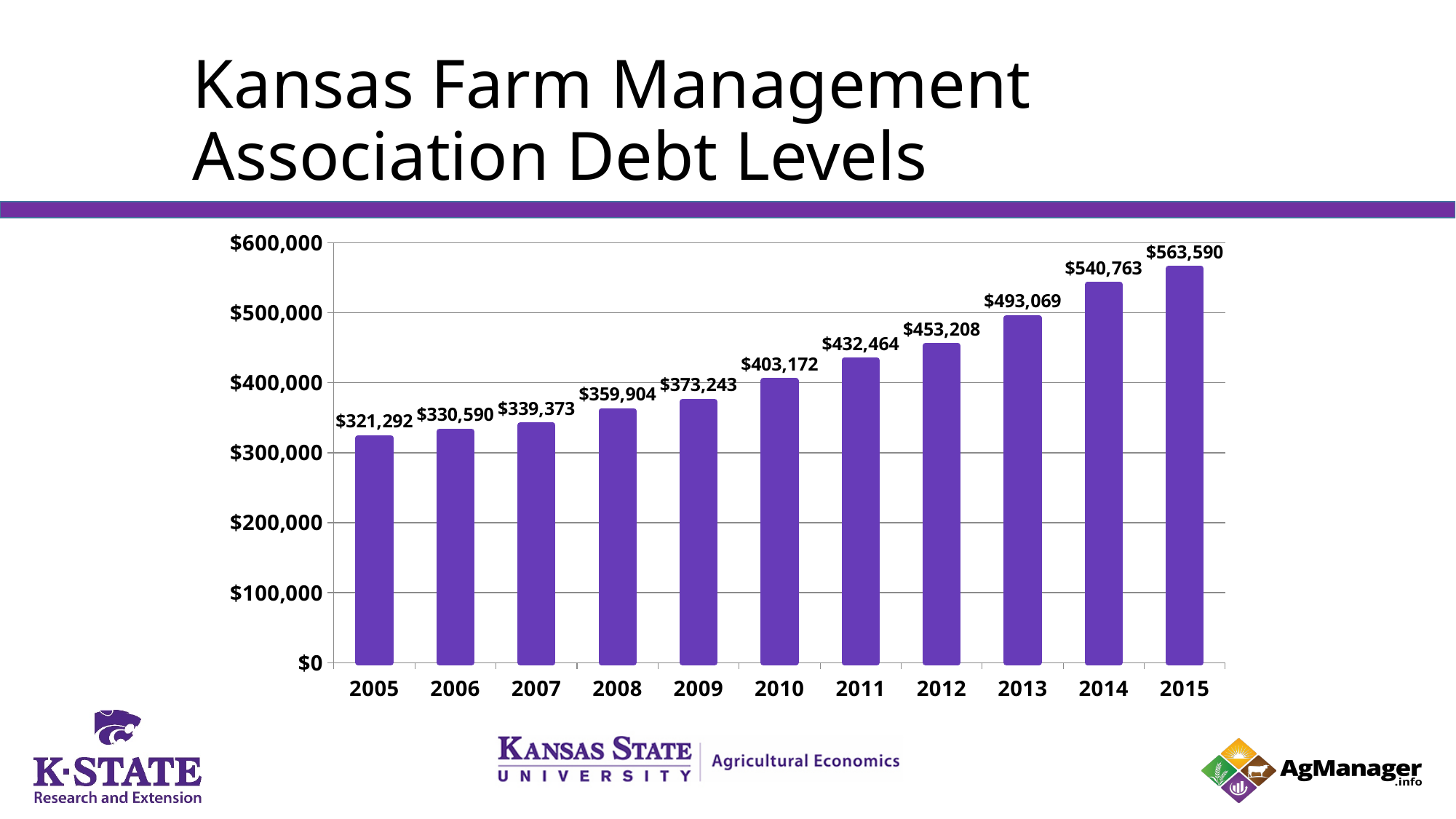
What is the debt level shown for 2005? $321,292 Which is larger, the debt level for 2011 or for 2012? 2012 Which year has the lowest debt level? 2005 What is the difference between the debt levels for 2009 and 2008? $13,339 Do the debt levels rise or fall from 2005 to 2015? rise Which year has the highest debt level? 2015 What kind of chart is shown on the slide? bar chart What is the debt level shown for 2013? $493,069 How many years are shown on the x axis? 11 Is the value for 2014 greater or less than $500,000? greater What is the difference between the debt levels for 2015 and 2014? $22,827 What is the debt level shown for 2010? $403,172